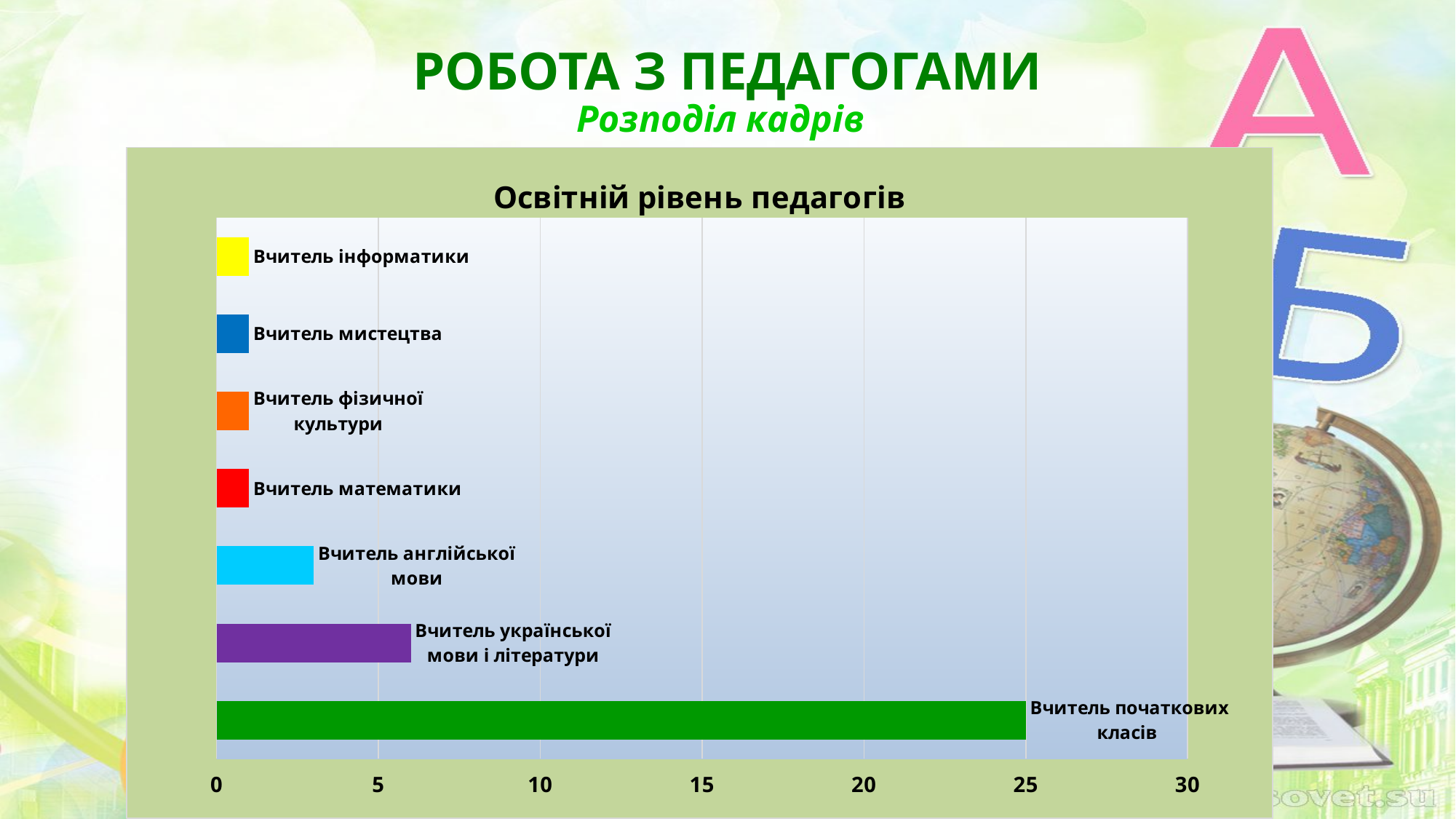
Is the value for Вчитель початкових класів greater or less than 20? greater Is the value for Вчитель англійської мови greater or less than 5? less Which is larger: the value for Вчитель української мови і літератури or the value for Вчитель англійської мови? Вчитель української мови і літератури What kind of chart is shown on the slide? bar chart What colour is the bar for Вчитель початкових класів? green Is the value for Вчитель української мови і літератури greater or less than 5? greater What is the title of the chart? Освітній рівень педагогів What is the value for Вчитель початкових класів? 25 Which category has the highest value? Вчитель початкових класів How many categories are plotted in the chart? 7